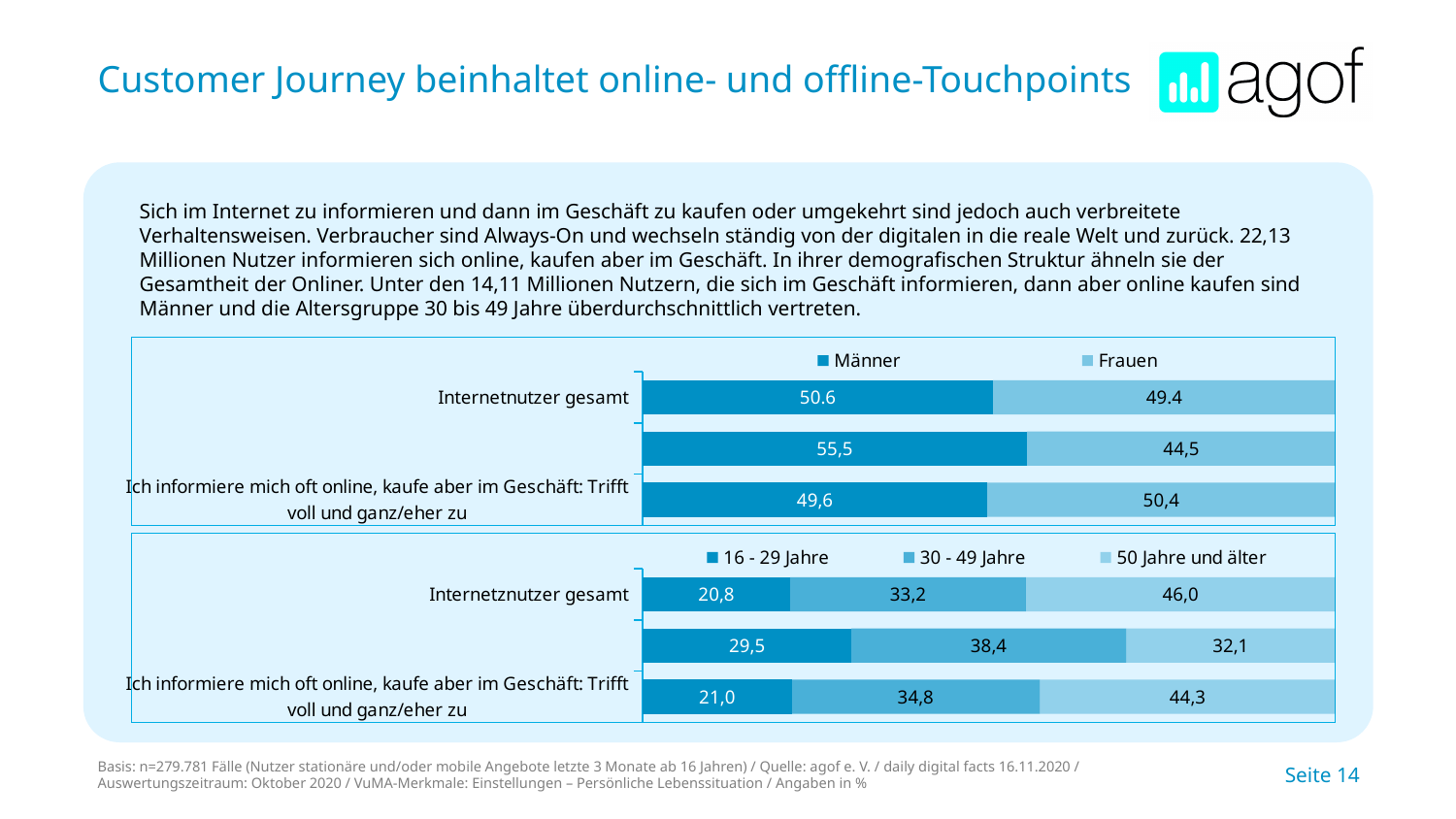
In the bottom chart (age groups), what is the value for '16 - 29 Jahre' for 'Ich informiere mich oft online, kaufe aber im Geschäft: Trifft voll und ganz/eher zu'? 21,0 How many series does the legend of the top chart list? 2 How many series does the legend of the bottom chart (age groups) list? 3 In the top chart (Männer/Frauen), what is the Frauen value for 'Ich informiere mich oft online, kaufe aber im Geschäft: Trifft voll und ganz/eher zu'? 50,4 In the bottom chart (age groups), what is the value for '50 Jahre und älter' for Internetnutzer gesamt? 46,0 In the top chart (Männer/Frauen), what is the Männer value for Internetnutzer gesamt? 50.6 In the bottom chart (age groups), what is the difference between the '30 - 49 Jahre' and '16 - 29 Jahre' values for 'Ich informiere mich oft online, kaufe aber im Geschäft: Trifft voll und ganz/eher zu'? 13,8 What kind of chart is the top chart on the slide? Stacked bar chart In the bottom chart (age groups), which age group has the largest share for Internetnutzer gesamt? 50 Jahre und älter In the top chart (Männer/Frauen), which is larger for 'Ich informiere mich oft online, kaufe aber im Geschäft: Trifft voll und ganz/eher zu', Männer or Frauen? Frauen In the bottom chart (age groups), what is the total of the three segments for Internetnutzer gesamt? 100,0 In the top chart (Männer/Frauen), what is the Männer value shown on the middle bar? 55,5